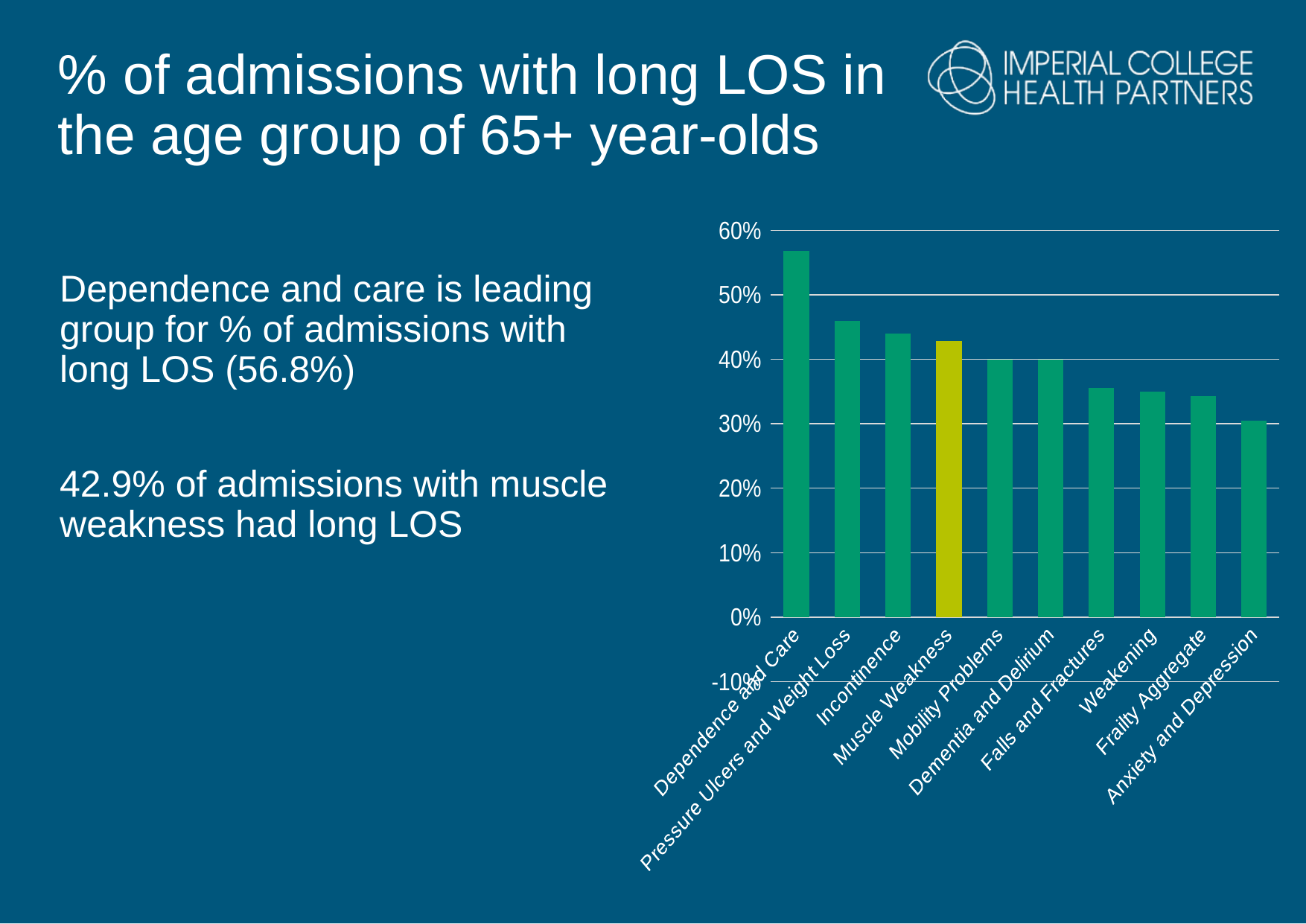
Which category's bar is shown in a different colour (yellow) from the others? Muscle Weakness Is the value for Pressure Ulcers and Weight Loss greater or less than 40%? greater Which category has the highest % of admissions with long LOS? Dependence and Care Which category has the lowest % of admissions with long LOS? Anxiety and Depression How many categories are plotted on the chart? 10 What is the difference between the values for Dependence and Care and Muscle Weakness? 13.9 percentage points What is the % of admissions with long LOS for Muscle Weakness? 42.9% What is the % of admissions with long LOS for Dependence and Care? 56.8% Which is larger, the value for Incontinence or the value for Weakening? Incontinence Do the values rise or fall moving from left to right along the x axis? Fall What kind of chart is shown on the slide? Bar chart Is the value for Falls and Fractures greater or less than 40%? less